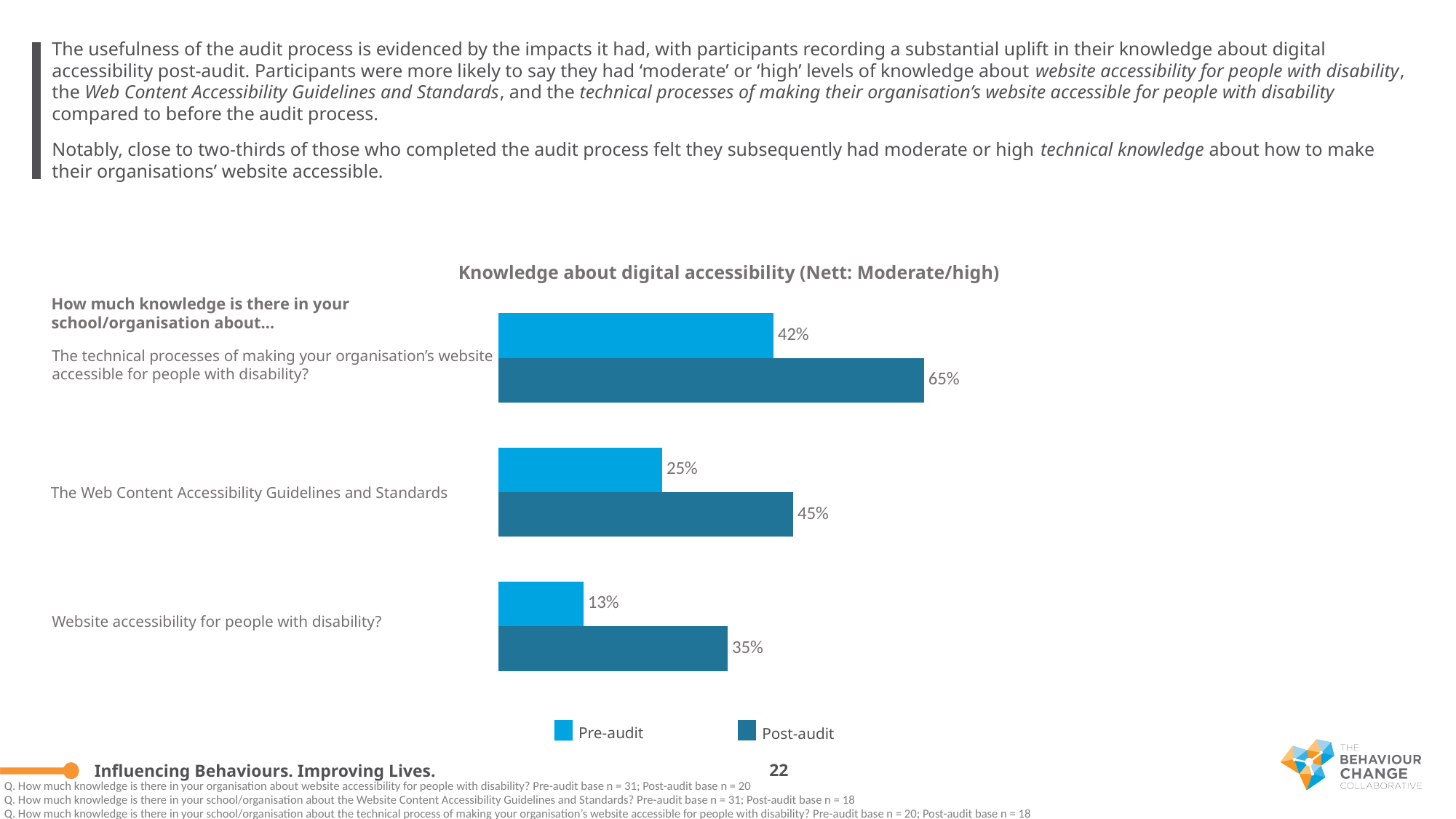
Which is larger: the Pre-audit value for 'The technical processes of making your organisation's website accessible for people with disability?' or the Post-audit value for 'Website accessibility for people with disability?' Pre-audit value for the technical processes (42%) Which category has the lowest Pre-audit value? Website accessibility for people with disability? What is the Pre-audit value for 'The Web Content Accessibility Guidelines and Standards'? 25% How many categories are shown in the chart? 3 What is the Post-audit value for 'The technical processes of making your organisation's website accessible for people with disability?' 65% What type of chart is shown on the slide? Bar chart What is the difference between the Post-audit and Pre-audit values for 'The Web Content Accessibility Guidelines and Standards'? 20% What is the Pre-audit value for 'Website accessibility for people with disability?' 13% Which category has the highest Post-audit value? The technical processes of making your organisation's website accessible for people with disability? How many series does the legend list? 2 What is the Post-audit value for 'Website accessibility for people with disability?' 35% What is the difference between the Post-audit and Pre-audit values for 'The technical processes of making your organisation's website accessible for people with disability?' 23%